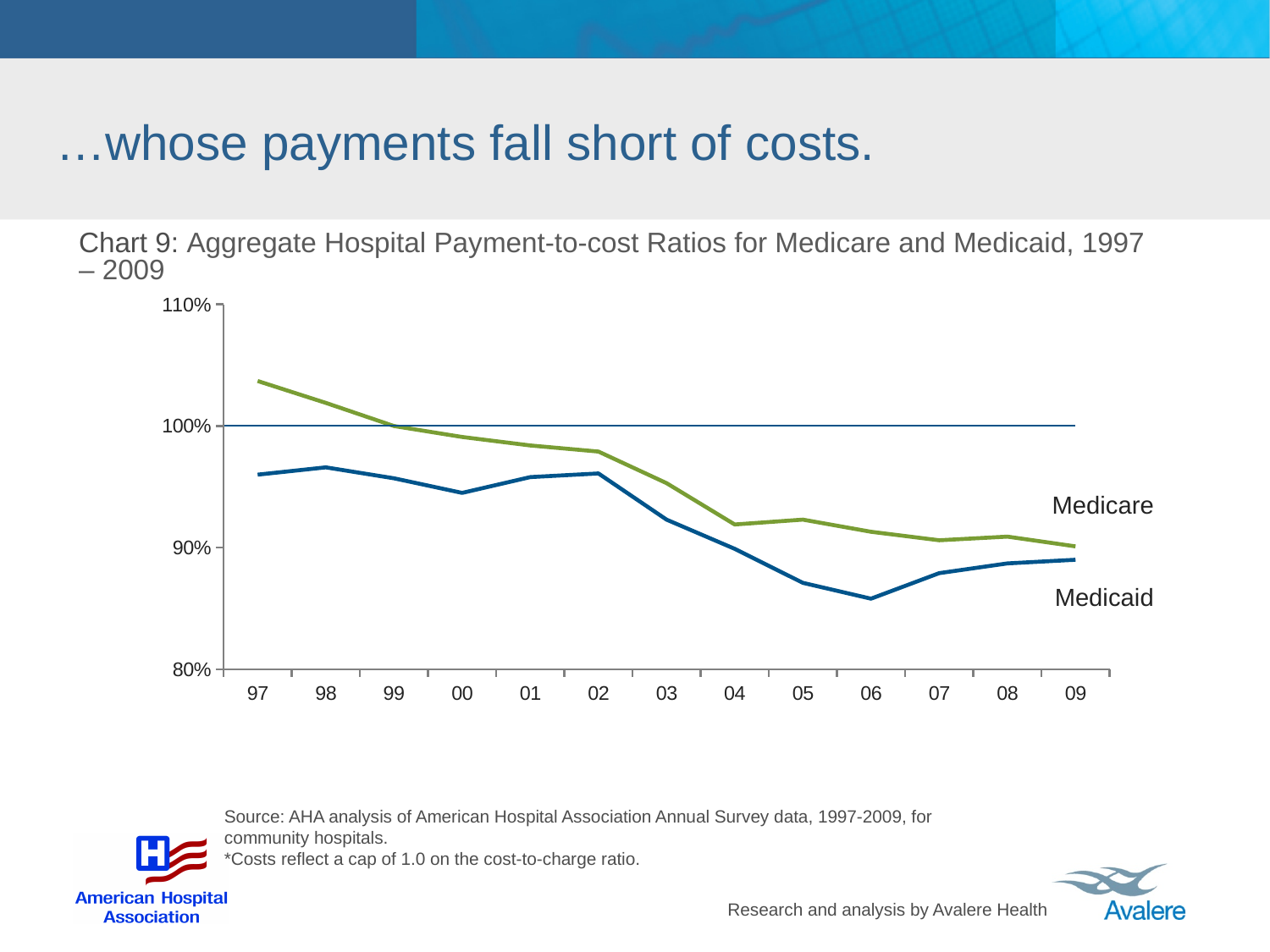
What kind of chart is shown on the slide? line chart Is the Medicare value for 97 greater or less than 100%? greater In which year does the Medicare line reach its highest value? 97 Is the Medicaid value for 06 greater or less than 90%? less Which is larger in 05, the Medicare value or the Medicaid value? Medicare At what level is the horizontal reference line drawn across the chart? 100% In which year does the Medicaid line reach its lowest value? 06 How many series are plotted in the chart? 2 Does the Medicare line generally rise or fall from 97 to 09? fall How many years are shown along the x axis of the chart? 13 Is the Medicaid value for 97 greater or less than 100%? less Which series has the highest value in 97? Medicare